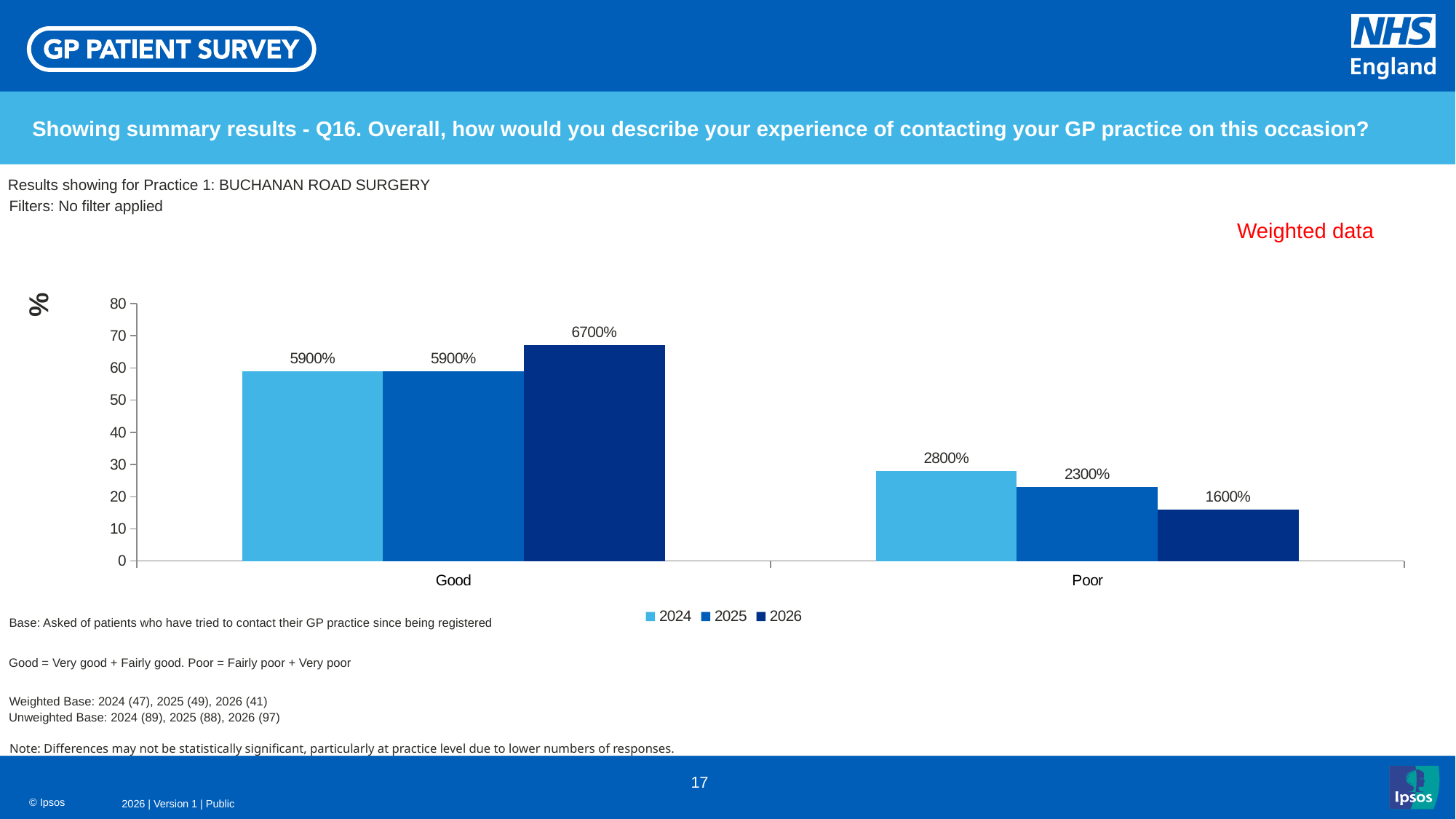
What kind of chart is shown on the slide? bar chart What is the data label for the 2026 bar in the Good category? 6700% What is the data label for the 2024 bar in the Good category? 5900% What is the difference between the data labels for 2024 and 2026 in the Poor category? 1200% What is the data label for the 2025 bar in the Poor category? 2300% What is the data label for the 2024 bar in the Poor category? 2800% How many series does the legend list? 3 Which year has the highest bar in the Good category? 2026 Is the 2025 bar for Poor larger or smaller than the 2024 bar for Poor? smaller Which practice are the results shown for? BUCHANAN ROAD SURGERY How many categories are shown on the x axis? 2 Which year has the lowest bar in the Poor category? 2026